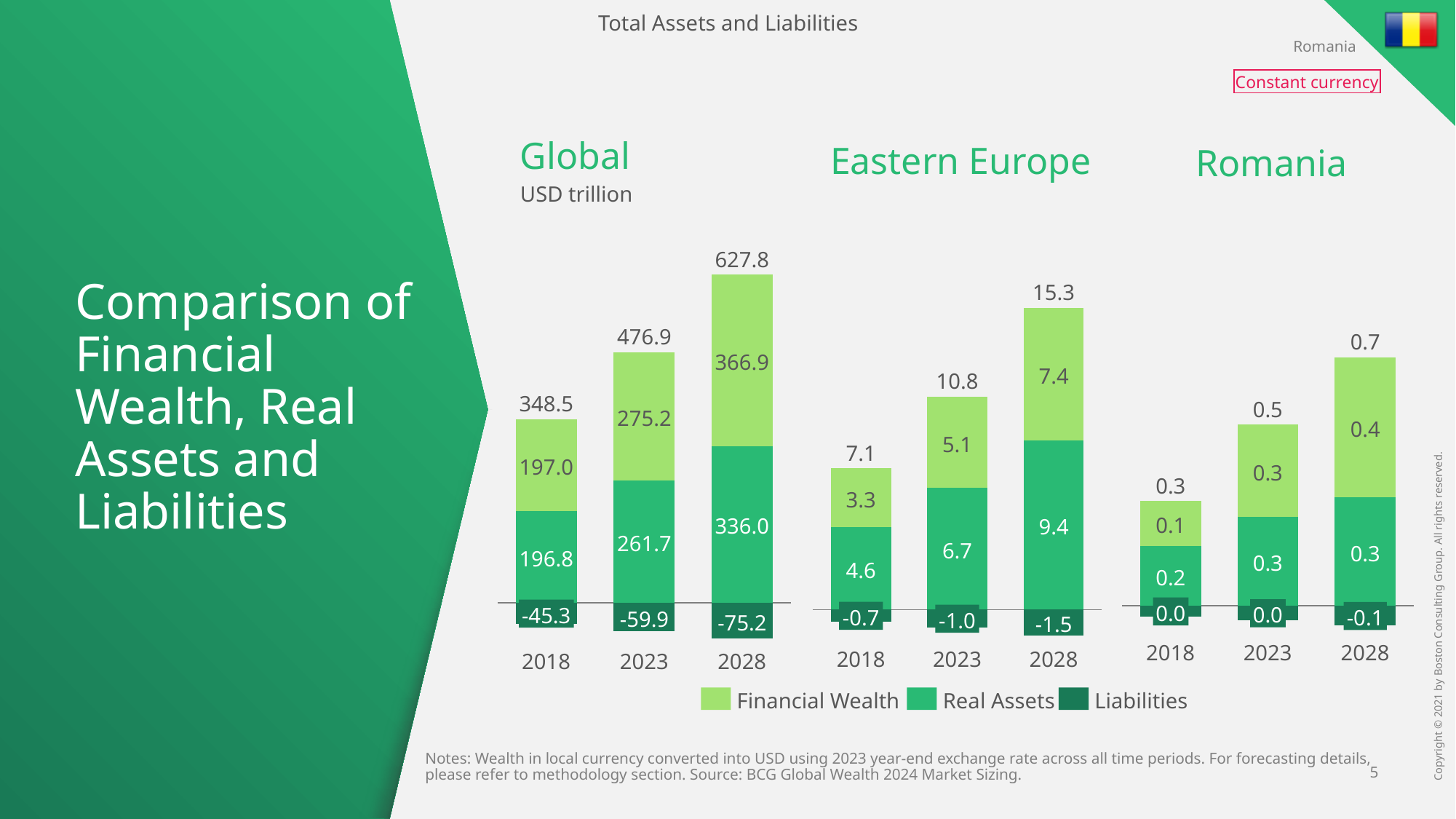
In the Global chart, what is the Financial Wealth value for 2023? 275.2 What kind of chart is used for the Global, Eastern Europe and Romania data? Stacked bar chart In the Romania chart, what is the Financial Wealth value for 2028? 0.4 In the Eastern Europe chart, which year has the lowest Financial Wealth value? 2018 In the Eastern Europe chart, what is the total printed above the 2023 bar? 10.8 In the Global chart, which year has the highest Real Assets value? 2028 In the Global chart, what is the total printed above the 2028 bar? 627.8 In the Global chart, what is the difference between the Financial Wealth values for 2028 and 2018? 169.9 How many series does the legend list? 3 In the Eastern Europe chart, what is the Real Assets value for 2028? 9.4 In the Global chart, what is the Liabilities value for 2028? -75.2 In the Eastern Europe chart, which is larger in 2023: Financial Wealth or Real Assets? Real Assets